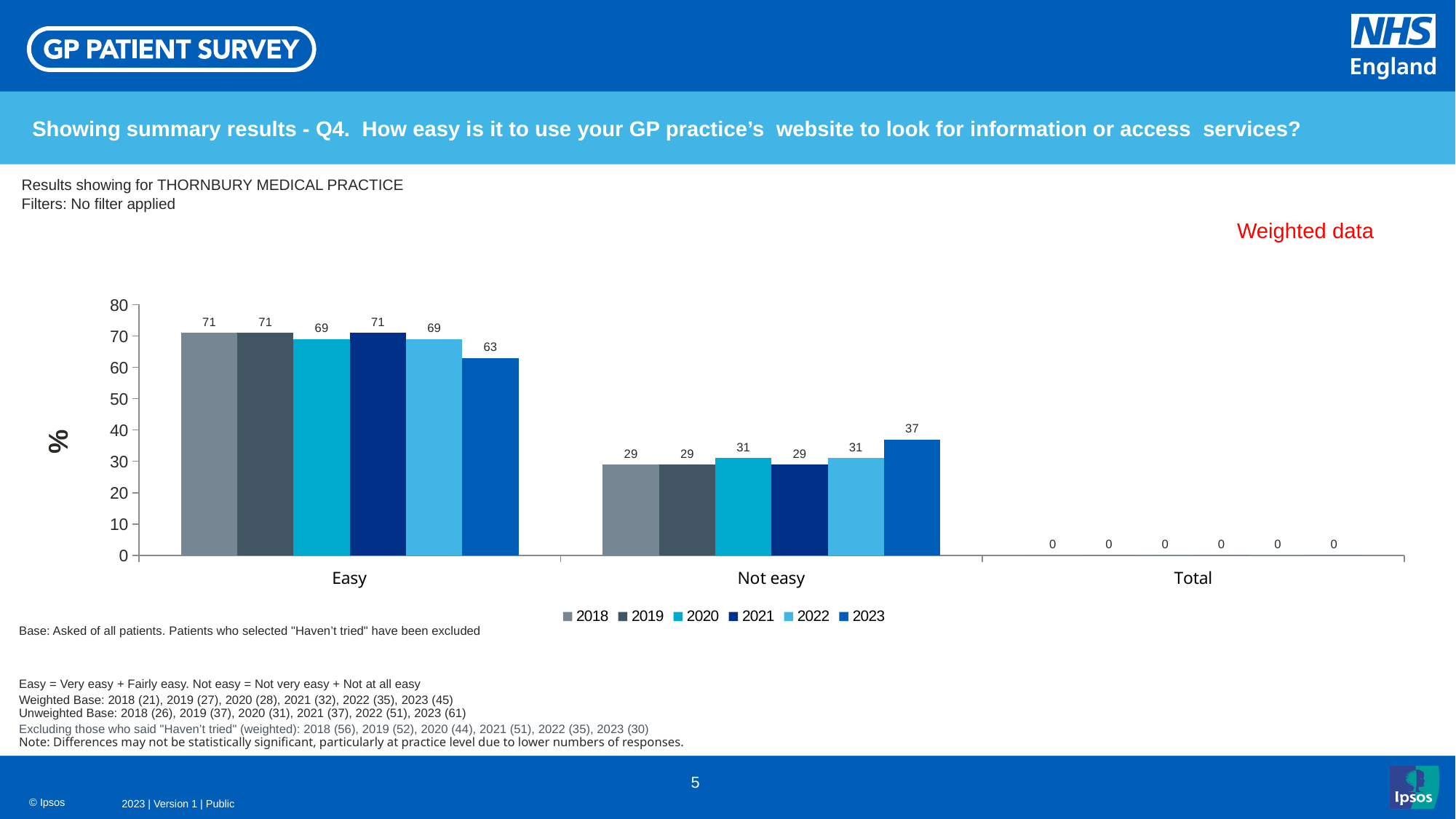
Which year has the highest value in the Not easy category? 2023 What is the value for 2020 in the Not easy category? 31 What is the value shown for every year in the Total category? 0 What is the difference between the 2018 and 2023 values in the Easy category? 8 How many series does the legend list? 6 What kind of chart is shown on the slide? Bar chart Which year has the lowest value in the Easy category? 2023 What is the value for 2018 in the Easy category? 71 How many categories are shown on the x axis? 3 What is the value for 2023 in the Easy category? 63 Which is larger: the 2021 value for Easy or the 2022 value for Easy? 2021 What is the difference between the Easy and Not easy values for 2023? 26